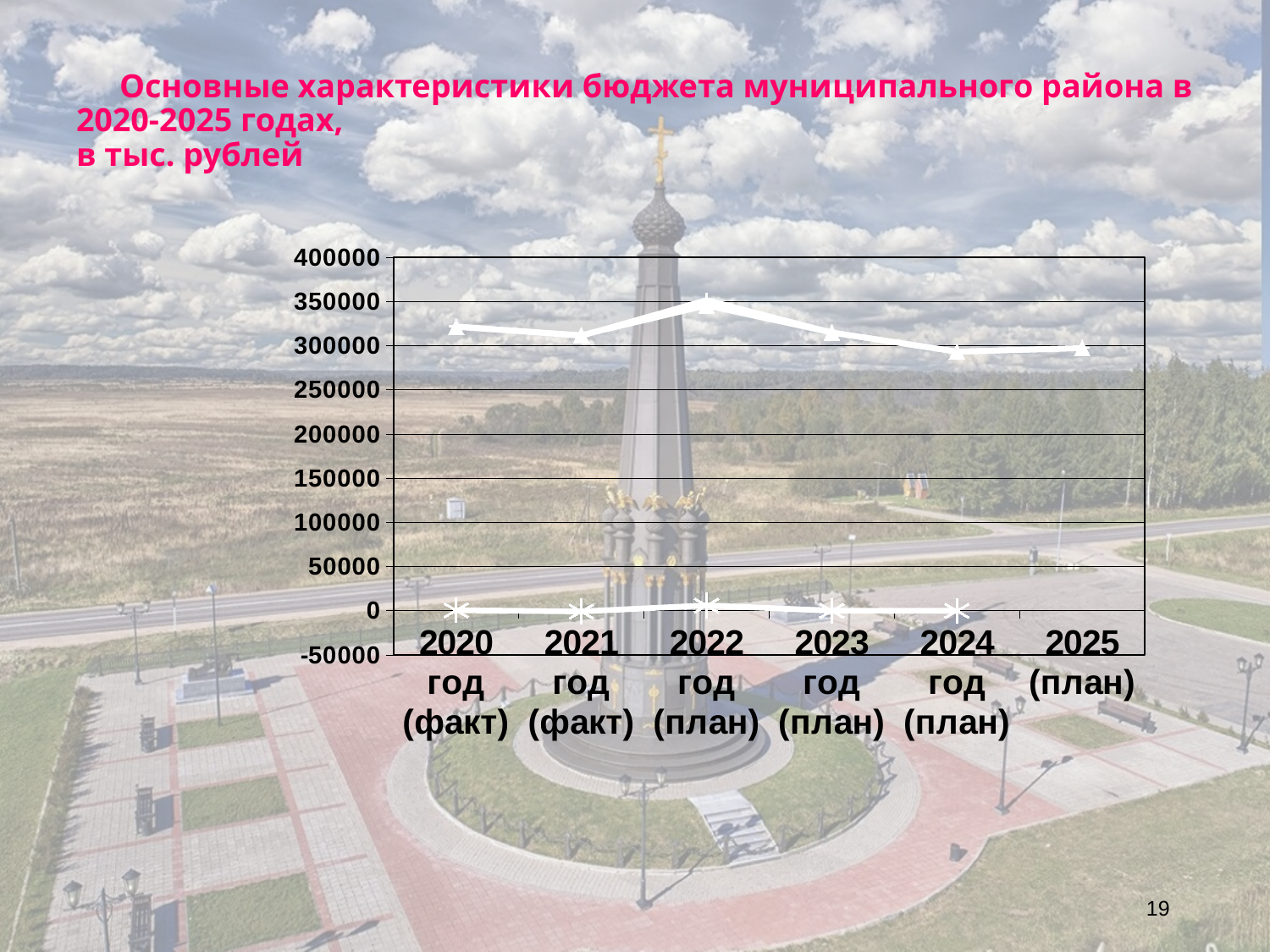
On the upper line (triangle markers), which is larger: the value for 2022 год (план) or for 2024 год (план)? 2022 год (план) On the lower line (star markers), is the value for 2022 год (план) greater or less than 50000? less What is the title of the chart on the slide? Основные характеристики бюджета муниципального района в 2020-2025 годах, в тыс. рублей What kind of chart is shown on the slide? line chart How many categories (years) are shown on the x axis of the chart? 6 On the upper line (triangle markers), do the values rise or fall from 2021 год (факт) to 2022 год (план)? rise On the upper line (triangle markers), do the values rise or fall from 2022 год (план) to 2024 год (план)? fall On the upper line (triangle markers), is the value for 2020 год (факт) greater or less than 300000? greater On the upper line (triangle markers), which year has the highest value? 2022 год (план) How many lines are plotted on the chart? 3 On the upper line (triangle markers), is the value for 2024 год (план) greater or less than 350000? less